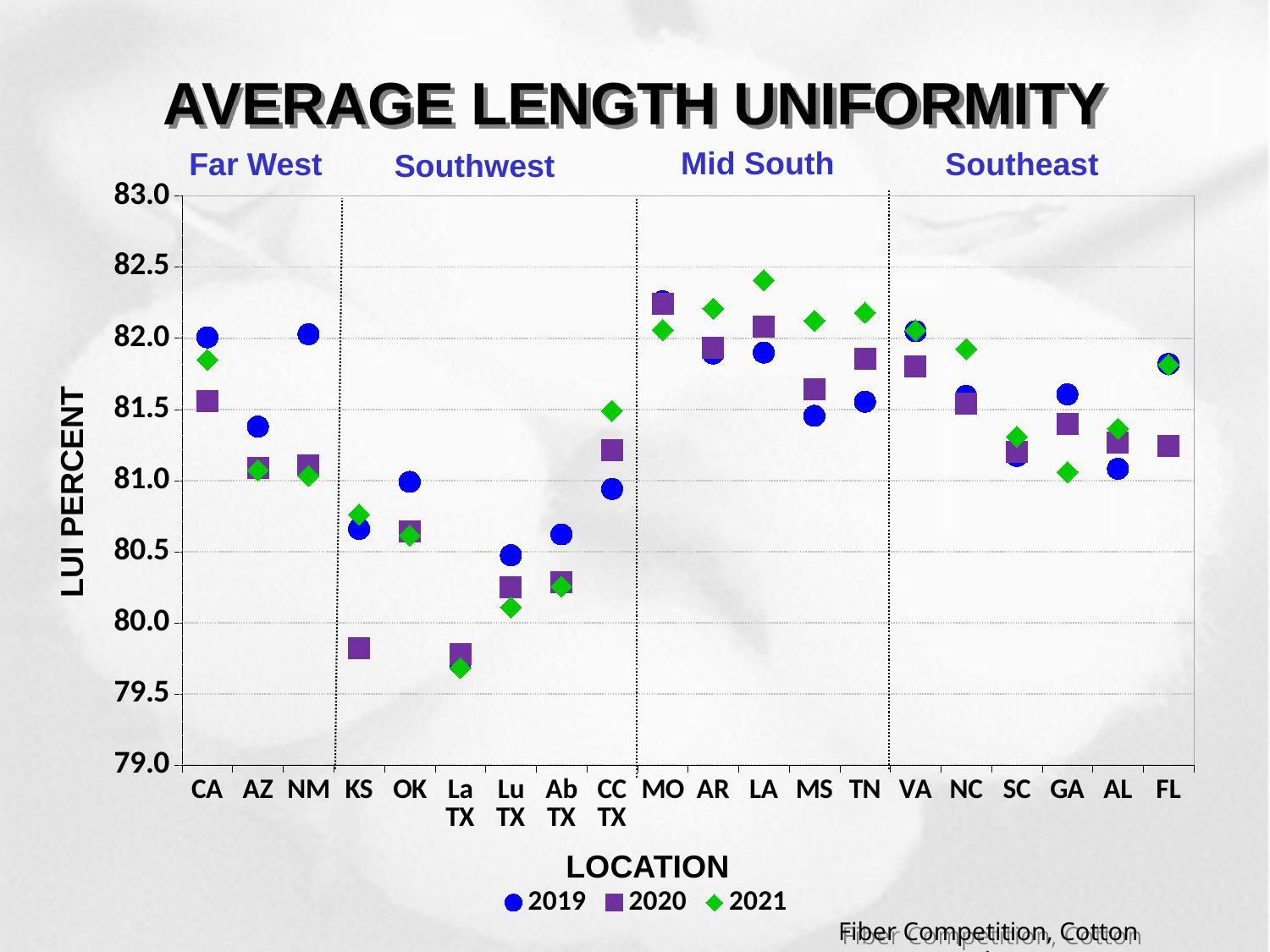
For CA, which is larger, the 2019 value or the 2020 value? 2019 How many locations are shown along the x axis? 20 Is the 2021 value for LA greater or less than 82.0? greater Which location has the highest 2019 value? MO Which region labels are shown above the chart? Far West, Southwest, Mid South, Southeast Which location has the lowest 2021 value? La TX What kind of chart is shown on the slide? scatter chart Is the 2020 value for KS greater or less than 80.0? less Is the 2019 value for CA greater or less than 81.5? greater Which location has the lowest 2019 value? La TX How many series does the legend list? 3 Which location has the highest 2021 value? LA